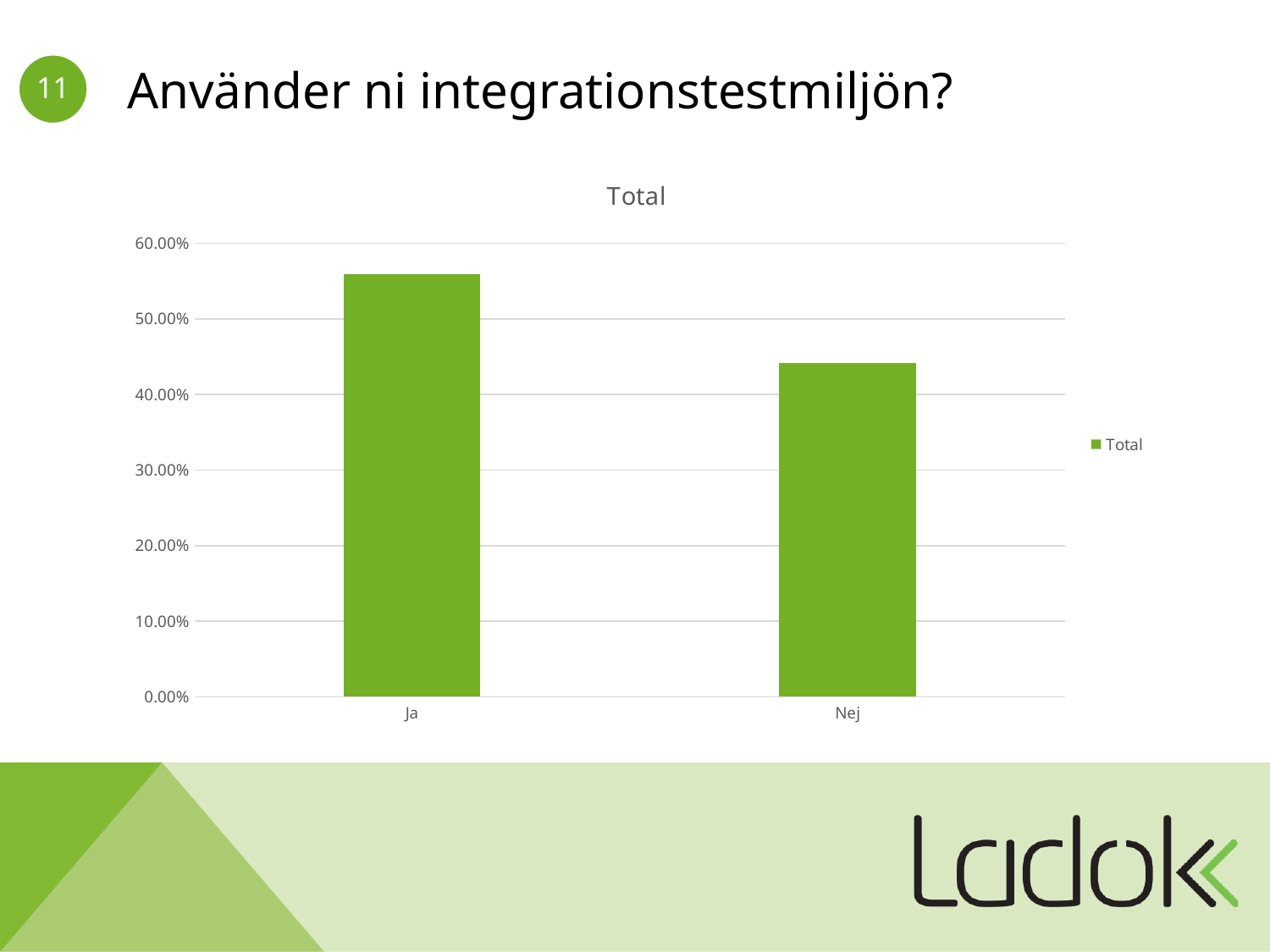
What is the name of the series shown in the legend? Total Is the value for Ja greater or less than 60.00%? less Is the value for Ja greater or less than 50.00%? greater What is the title of the chart? Total How many categories are shown on the x axis? 2 What kind of chart is shown on the slide? bar chart Is the value for Nej greater or less than 40.00%? greater How many series does the legend list? 1 Which is larger, the value for Ja or the value for Nej? Ja Which category has the lowest value? Nej Which category has the highest value? Ja